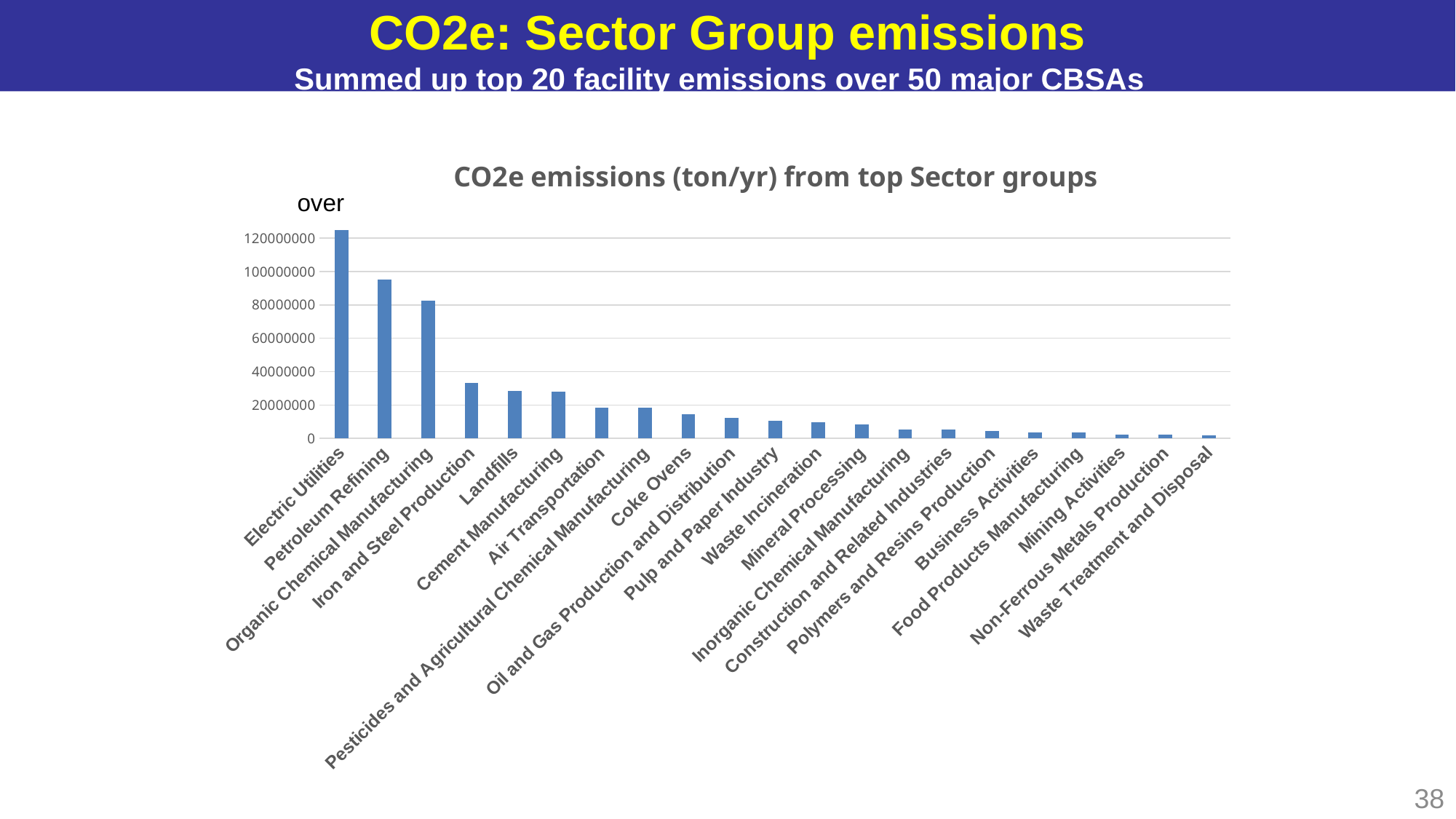
Do the values rise or fall moving from left to right along the x axis? fall Is the value for Landfills greater or less than 20000000? greater Which sector group has the highest CO2e emissions? Electric Utilities Is the value for Coke Ovens greater or less than 20000000? less Which sector group has the lowest CO2e emissions? Waste Treatment and Disposal What kind of chart is shown on the slide? bar chart Is the value for Iron and Steel Production greater or less than 40000000? less What is the title of the chart? CO2e emissions (ton/yr) from top Sector groups How many sector groups are plotted in the chart? 21 Which has higher CO2e emissions, Petroleum Refining or Organic Chemical Manufacturing? Petroleum Refining